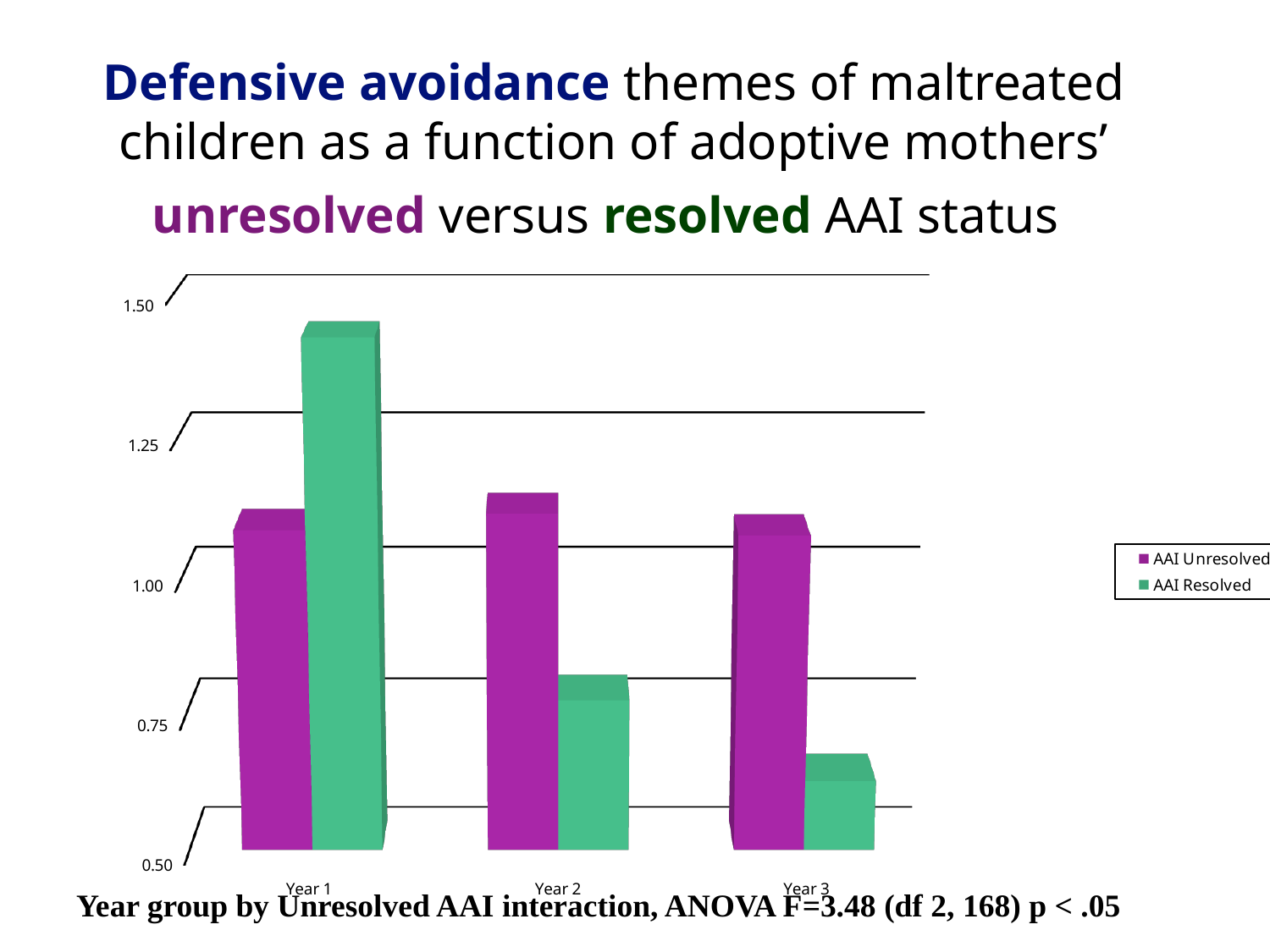
In Year 1, which is larger: AAI Unresolved or AAI Resolved? AAI Resolved How many series does the legend list? 2 Is the value for AAI Resolved in Year 3 greater or less than 0.75? less Do the AAI Resolved values rise or fall from Year 1 to Year 3? fall In which year group is the AAI Resolved bar the highest? Year 1 What kind of chart is shown on the slide? bar chart How many year groups are shown on the x axis? 3 Which series is shown in green? AAI Resolved In which year group is the AAI Resolved bar the lowest? Year 3 Is the value for AAI Resolved in Year 1 greater or less than 1.25? greater Is the value for AAI Unresolved in Year 2 greater or less than 1.00? greater In Year 3, which is larger: AAI Unresolved or AAI Resolved? AAI Unresolved